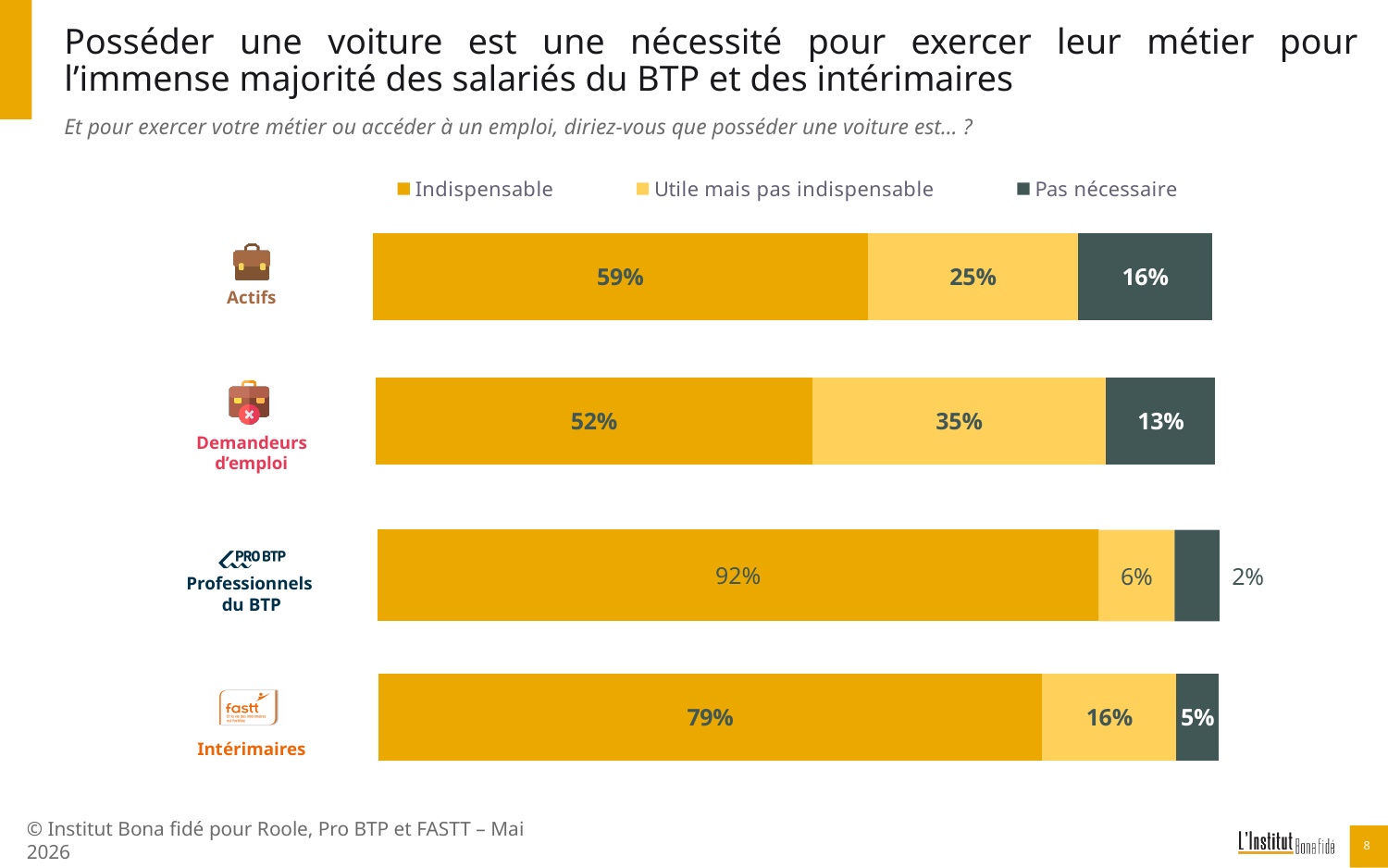
How many series does the legend list? 3 How many categories are shown in the chart? 4 What percentage of Professionnels du BTP say owning a car is "Indispensable"? 92% Which category has the lowest "Indispensable" share? Demandeurs d'emploi What is the total of the three segments for the Actifs bar? 100% What kind of chart is shown on the slide? Stacked bar chart What is the "Utile mais pas indispensable" value for Demandeurs d'emploi? 35% What is the difference between the "Indispensable" values for Intérimaires and Actifs? 20 percentage points Which category has the highest "Indispensable" share? Professionnels du BTP Which is larger: the "Pas nécessaire" value for Actifs or for Demandeurs d'emploi? Actifs What is the "Pas nécessaire" value for Intérimaires? 5% Which legend entry is shown in dark green? Pas nécessaire